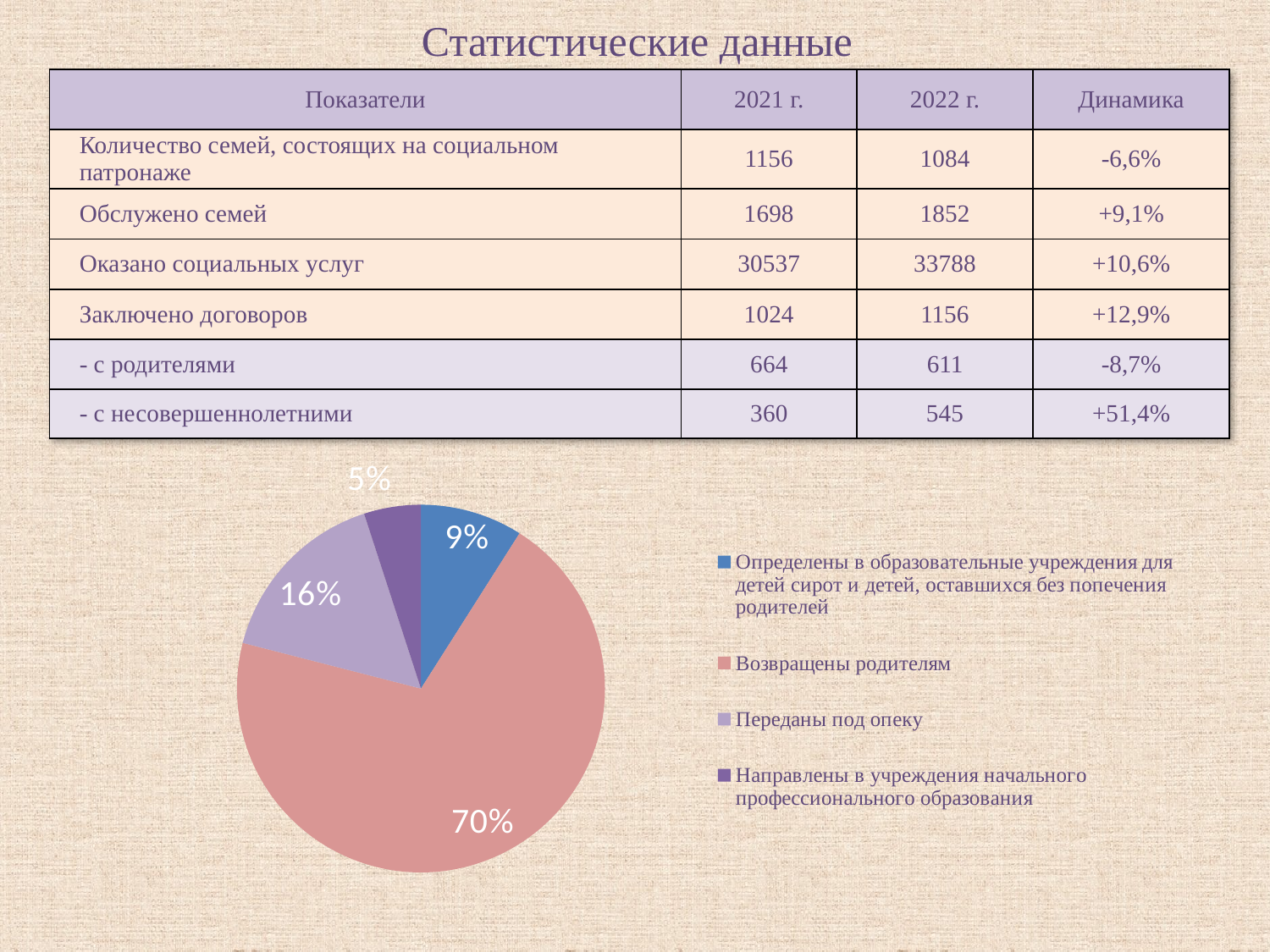
What share of the pie does "Переданы под опеку" take? 16% Which category has the largest slice in the pie chart? Возвращены родителям Which category has the smallest slice in the pie chart? Направлены в учреждения начального профессионального образования How many entries does the pie chart's legend list? 4 How many slices does the pie chart have? 4 Which is larger in the pie chart: "Переданы под опеку" or "Определены в образовательные учреждения для детей сирот и детей, оставшихся без попечения родителей"? Переданы под опеку What share of the pie does "Направлены в учреждения начального профессионального образования" take? 5% What is the difference in percentage points between "Возвращены родителям" and "Переданы под опеку"? 54 What kind of chart is shown on the slide? pie chart What share of the pie does "Определены в образовательные учреждения для детей сирот и детей, оставшихся без попечения родителей" take? 9% What colour is the slice for "Возвращены родителям" in the pie chart? pink